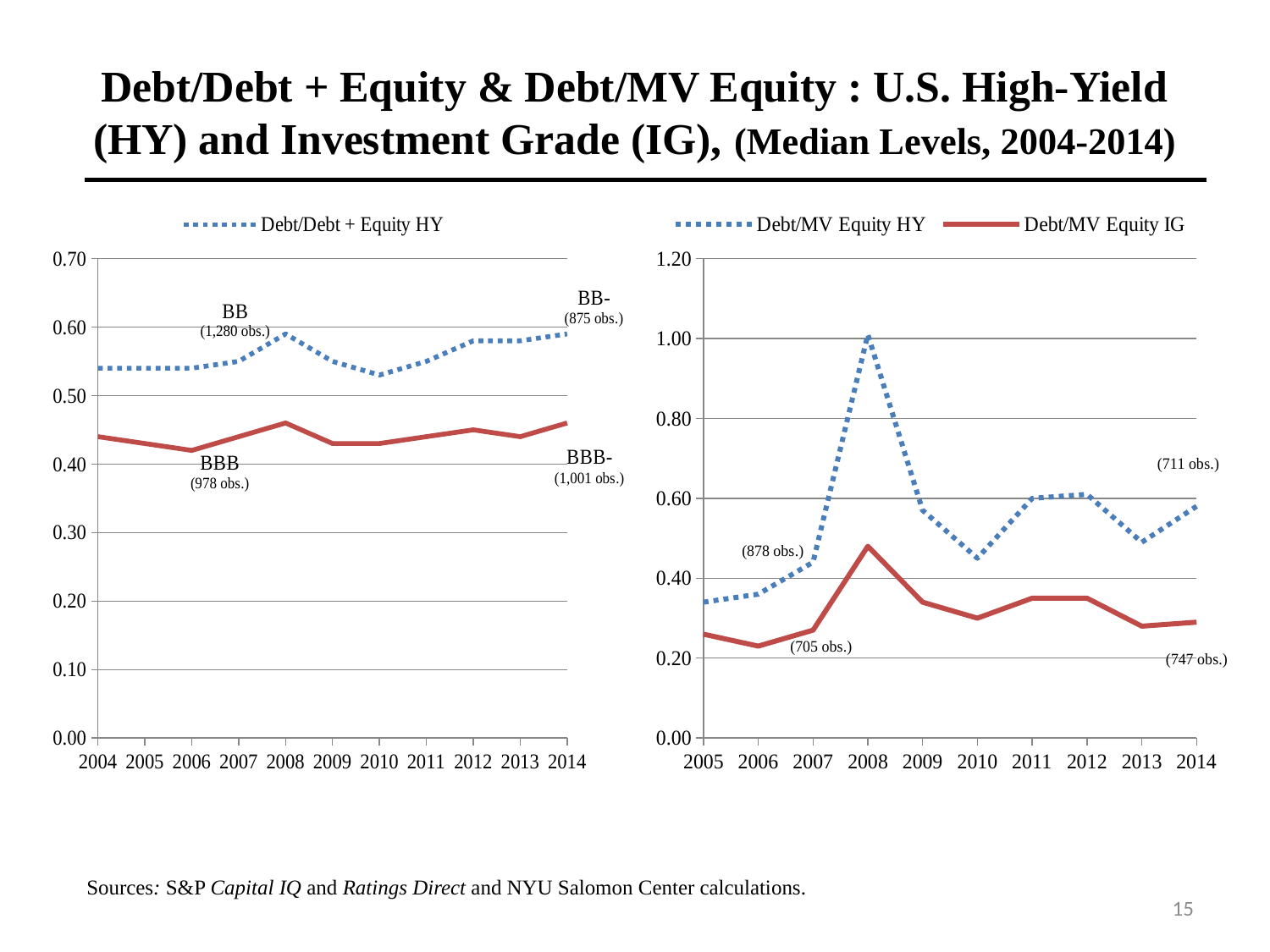
In the left chart, how many observations are noted for the BB label? 1,280 obs. In the right chart, in which year does the Debt/MV Equity IG series reach its highest value? 2008 How many years are shown on the x axis of the right chart? 10 In the right chart, in which year does the Debt/MV Equity HY series reach its highest value? 2008 How many years are shown on the x axis of the left chart? 11 In the right chart, does the Debt/MV Equity HY series rise or fall from 2008 to 2010? fall What kind of chart is the left chart (Debt/Debt + Equity HY)? line chart In the left chart, is the Debt/Debt + Equity HY value for 2010 greater or less than 0.50? greater In the right chart, is the Debt/MV Equity IG value for 2008 greater or less than 0.60? less In the right chart, which series has the larger value in 2008, Debt/MV Equity HY or Debt/MV Equity IG? Debt/MV Equity HY In the right chart, is the Debt/MV Equity HY value for 2008 greater or less than 0.80? greater How many series does the legend of the right chart list? 2